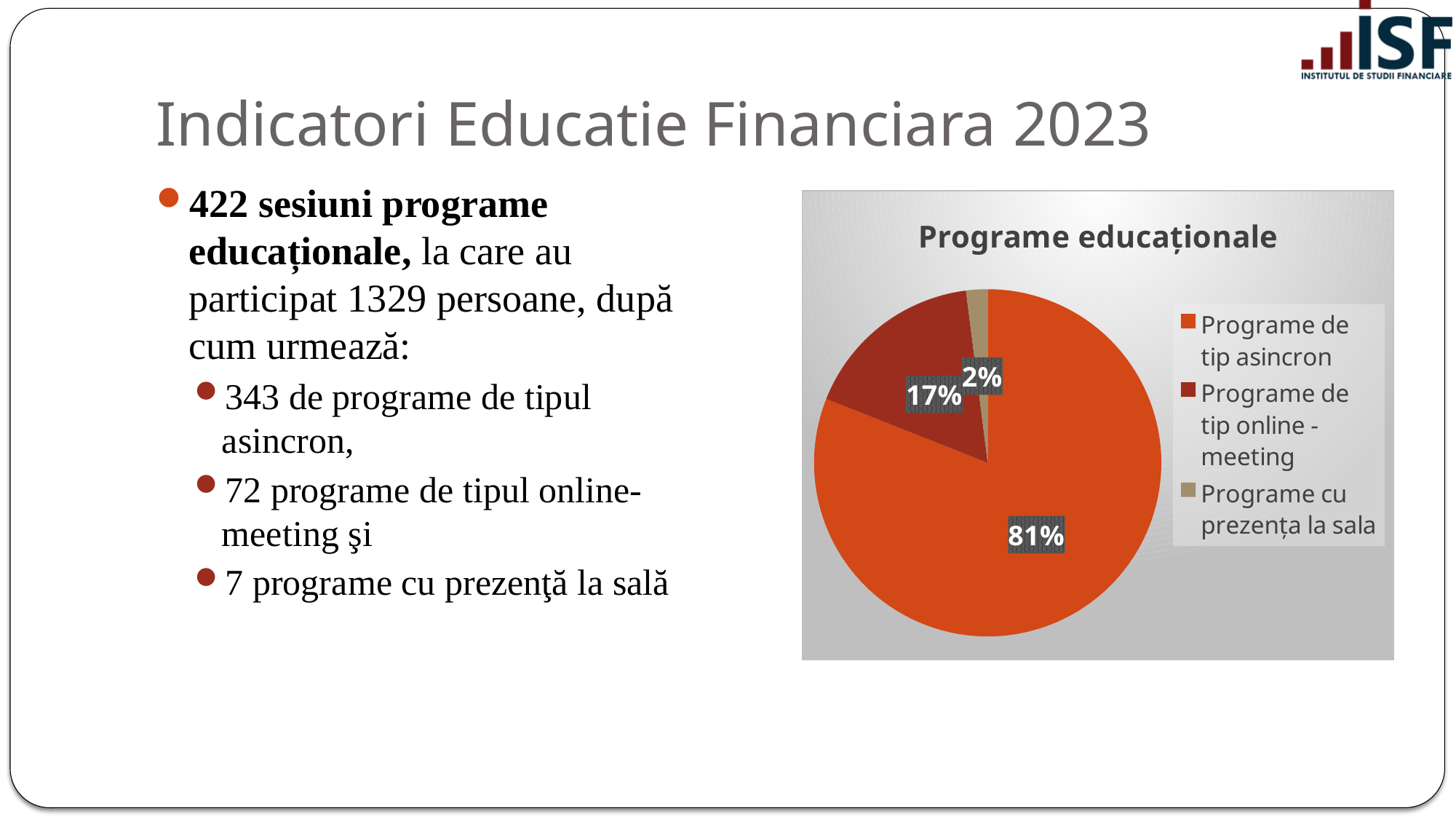
How many slices does the pie chart have? 3 Which category has the largest slice of the pie? Programe de tip asincron What is the difference in percentage points between the "Programe de tip asincron" slice and the "Programe de tip online - meeting" slice? 64 What is the title of the chart? Programe educaționale What share of the pie is labelled for "Programe cu prezența la sala"? 2% What share of the pie is labelled for "Programe de tip asincron"? 81% How many entries does the legend list? 3 What colour is the slice for "Programe de tip asincron"? orange What share of the pie is labelled for "Programe de tip online - meeting"? 17% What type of chart is shown on the slide? pie chart Which slice is larger: "Programe de tip online - meeting" or "Programe cu prezența la sala"? Programe de tip online - meeting Which category has the smallest slice of the pie? Programe cu prezența la sala